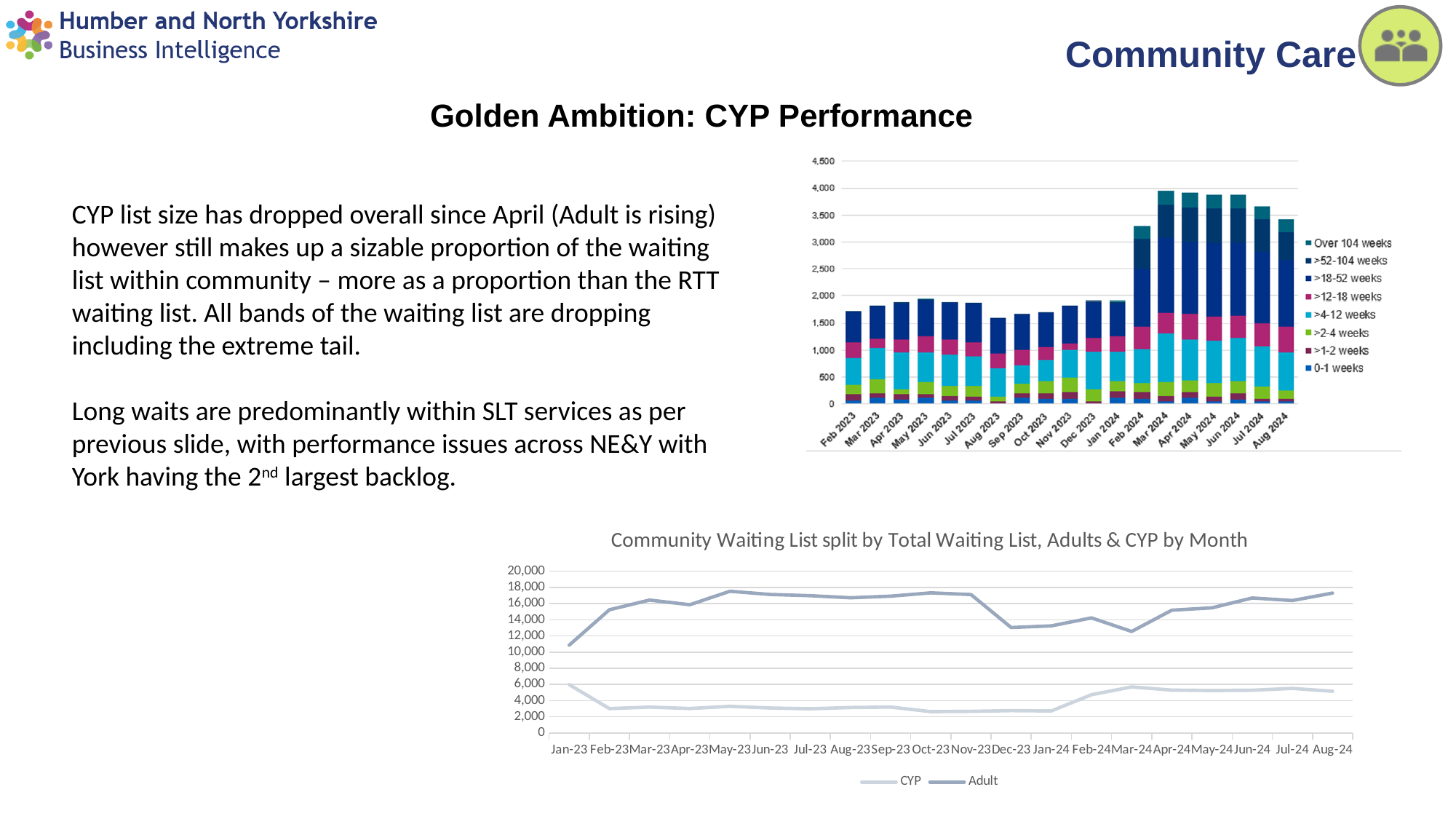
In the top-right stacked bar chart, which month has the lowest total bar? Aug 2023 In the bottom line chart, which series has the larger value in Aug-24, CYP or Adult? Adult In the top-right stacked bar chart, is the total for Mar 2024 greater or less than 3,500? greater In the bottom line chart, which month has the lowest Adult value? Jan-23 What type of chart is the bottom chart titled 'Community Waiting List split by Total Waiting List, Adults & CYP by Month'? Line chart How many series does the legend of the bottom line chart list? 2 In the bottom line chart, is the Adult value for Mar-24 greater or less than 14,000? less In the top-right stacked bar chart, is the total for Feb 2023 greater or less than 2,000? less How many series does the legend of the top-right stacked bar chart list? 8 How many months are plotted along the x axis of the top-right stacked bar chart? 19 How many months are plotted along the x axis of the bottom line chart? 20 What type of chart is the top-right chart showing waiting time bands by month? Stacked bar chart